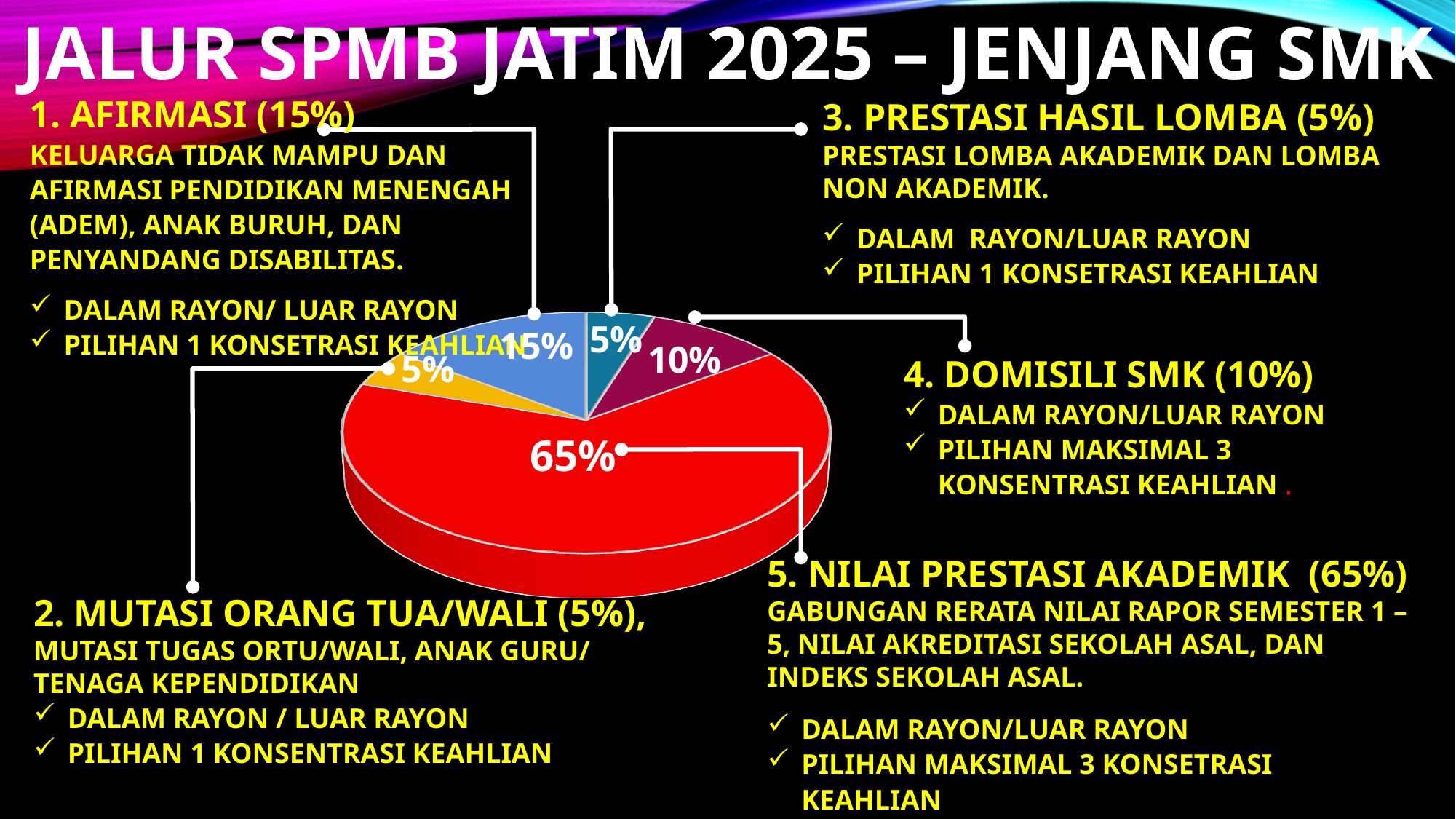
What share of the pie does Domisili SMK have? 10% What is the title of the slide containing the pie chart? JALUR SPMB JATIM 2025 – JENJANG SMK What is the difference between the Nilai Prestasi Akademik share and the Afirmasi share? 50% What share of the pie does Prestasi Hasil Lomba have? 5% How many slices does the pie chart have? 5 Which is larger, the Afirmasi share or the Domisili SMK share? Afirmasi What share of the pie does Afirmasi have? 15% What kind of chart is shown on the slide? pie chart Which slice of the pie is the largest? Nilai Prestasi Akademik (65%) What is the difference between the Afirmasi share and the Domisili SMK share? 5% What colour is the largest slice of the pie? red